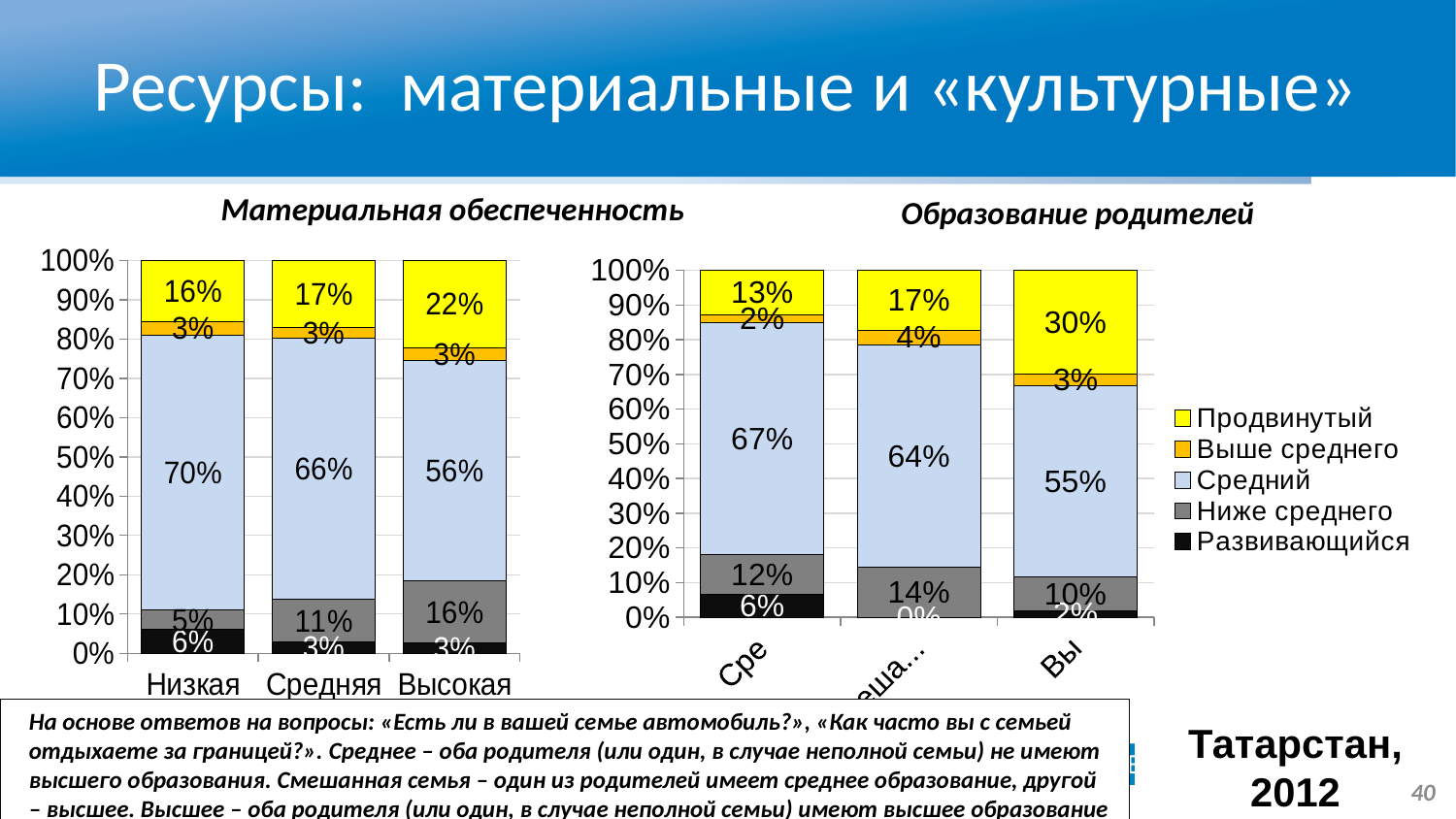
In the 'Материальная обеспеченность' chart, what is the value of 'Средний' for 'Низкая'? 70% How many categories are shown on the x axis of the 'Материальная обеспеченность' chart? 3 In the 'Материальная обеспеченность' chart, what is the difference between the 'Средний' values for 'Низкая' and 'Высокая'? 14 percentage points In the 'Материальная обеспеченность' chart, which category has the highest share of 'Продвинутый'? Высокая In the 'Материальная обеспеченность' chart, which has the larger 'Ниже среднего' value, 'Низкая' or 'Высокая'? Высокая In the 'Образование родителей' chart, what is the value of 'Средний' in the leftmost bar? 67% In the 'Образование родителей' chart, what is the value of 'Продвинутый' in the rightmost bar? 30% In the 'Образование родителей' chart, which bar has the highest 'Продвинутый' share: the leftmost, middle or rightmost? Rightmost How many series does the legend list? 5 What kind of chart is the 'Материальная обеспеченность' chart on the left? Stacked bar chart In the 'Материальная обеспеченность' chart, what is the value of 'Продвинутый' for 'Высокая'? 22% In the 'Материальная обеспеченность' chart, what is the value of 'Ниже среднего' for 'Средняя'? 11%